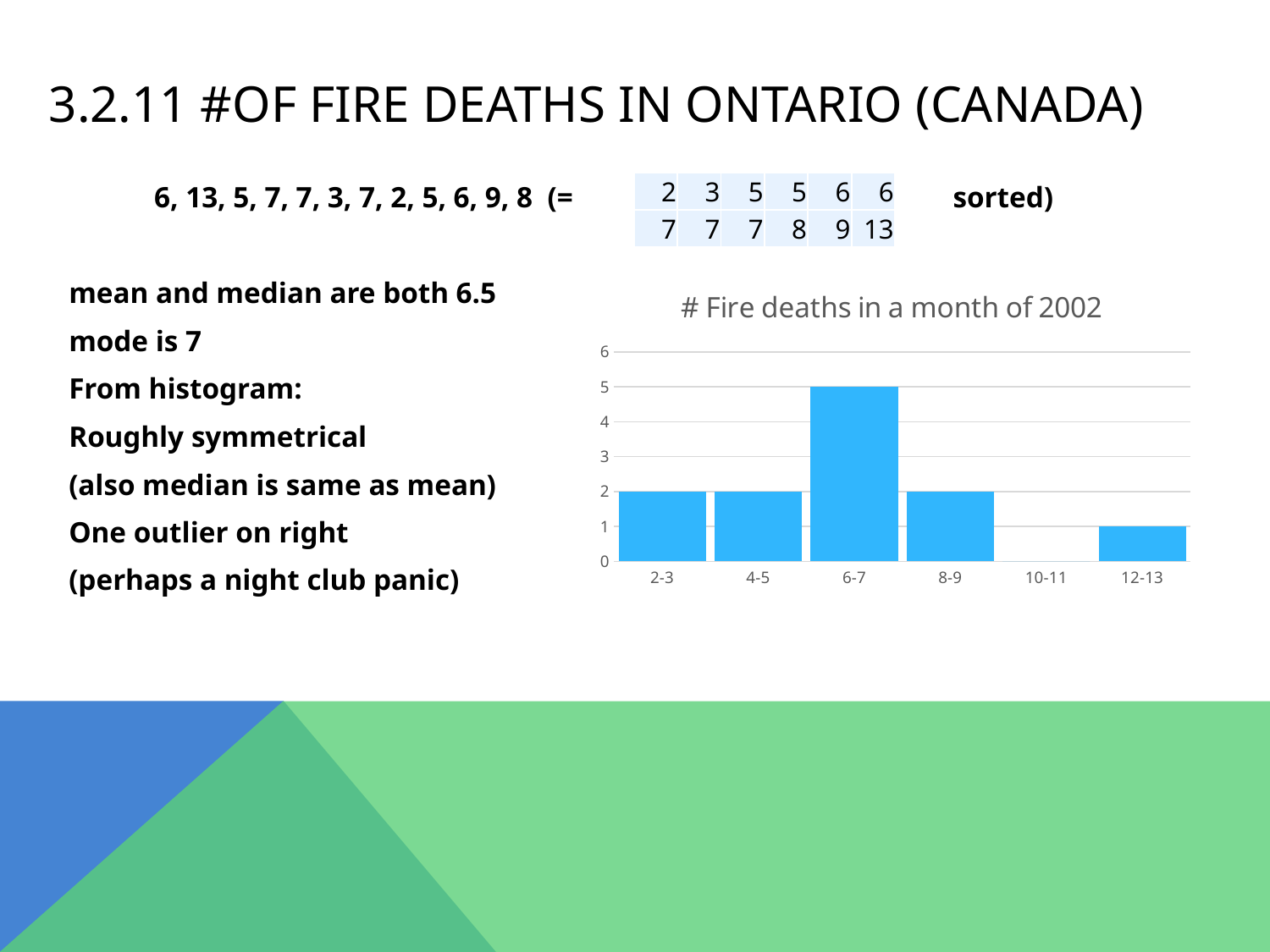
Which bin has the highest bar in the chart? 6-7 Which bin has the lowest value in the chart? 10-11 What is the value for the 2-3 bin? 2 What kind of chart is shown on the slide? bar chart Is the value for the 6-7 bin greater or less than 4? greater How many bins (categories) are shown on the x axis of the chart? 6 What is the difference between the values for the 6-7 bin and the 8-9 bin? 3 What is the value for the 12-13 bin? 1 What is the title of the chart? # Fire deaths in a month of 2002 What is the value for the 6-7 bin? 5 Which is larger, the value for the 4-5 bin or the value for the 12-13 bin? 4-5 What is the highest value shown on the y axis of the chart? 6